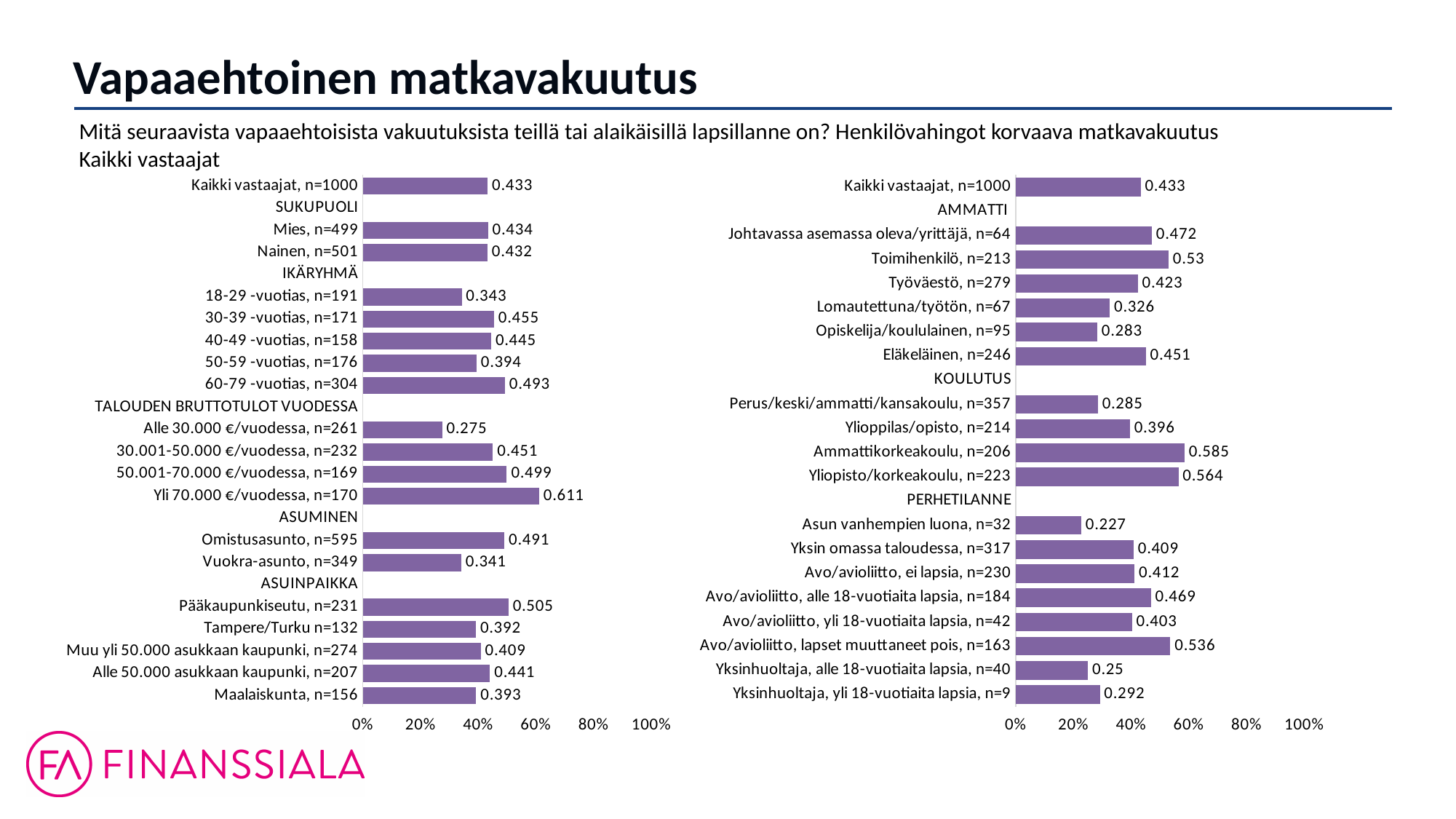
In the left chart, what is the value for Yli 70.000 €/vuodessa, n=170? 0.611 In the left chart, which category has the lowest value? Alle 30.000 €/vuodessa, n=261 In the right chart, what is the difference between the values for Toimihenkilö, n=213 and Työväestö, n=279? 0.107 What kind of chart is the right chart? bar chart In the left chart, what is the value for Pääkaupunkiseutu, n=231? 0.505 In the right chart, which category has the lowest value? Asun vanhempien luona, n=32 In the right chart, is the value for Opiskelija/koululainen, n=95 greater or less than 40%? less How many bars are plotted in the left chart? 19 In the right chart, what is the value for Toimihenkilö, n=213? 0.53 In the left chart, what is the difference between the values for Omistusasunto, n=595 and Vuokra-asunto, n=349? 0.15 In the right chart, which category has the highest value? Ammattikorkeakoulu, n=206 In the left chart, which is larger: the value for 18-29 -vuotias, n=191 or 60-79 -vuotias, n=304? 60-79 -vuotias, n=304